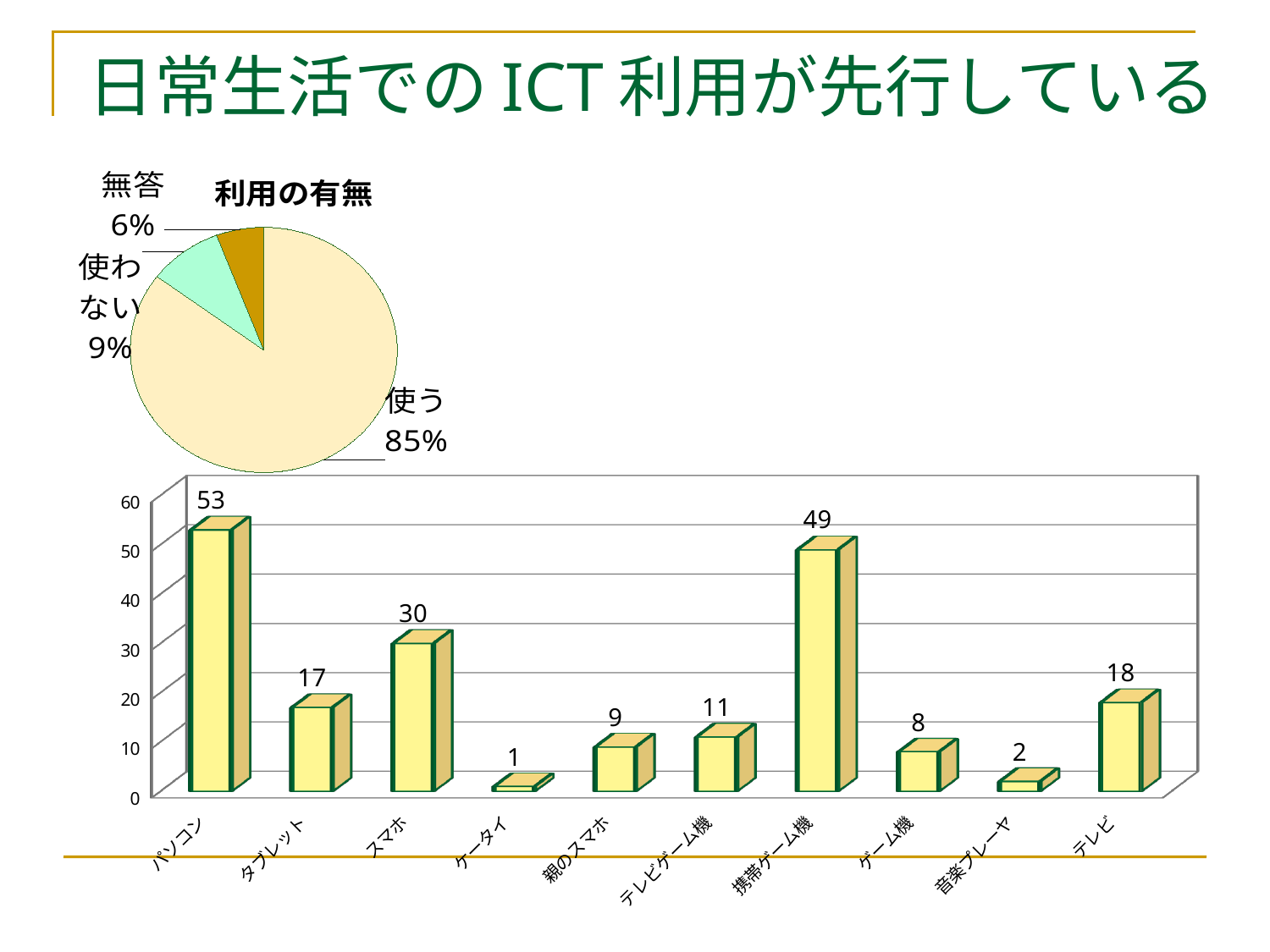
In the bar chart at the bottom of the slide, which category has the highest value? パソコン In the pie chart titled 利用の有無, what share does 無答 have? 6% In the pie chart titled 利用の有無, what share does 使う have? 85% In the bar chart at the bottom of the slide, how many categories are shown on the x axis? 10 What kind of chart is the chart at the bottom of the slide? bar chart In the bar chart at the bottom of the slide, what is the value for 携帯ゲーム機? 49 In the pie chart titled 利用の有無, how many slices are there? 3 In the bar chart at the bottom of the slide, what is the difference between the values for スマホ and タブレット? 13 In the bar chart at the bottom of the slide, which category has the lowest value? ケータイ In the bar chart at the bottom of the slide, which is larger, the value for テレビ or the value for テレビゲーム機? テレビ In the pie chart titled 利用の有無, which slice is the smallest? 無答 In the bar chart at the bottom of the slide, what is the value for パソコン? 53